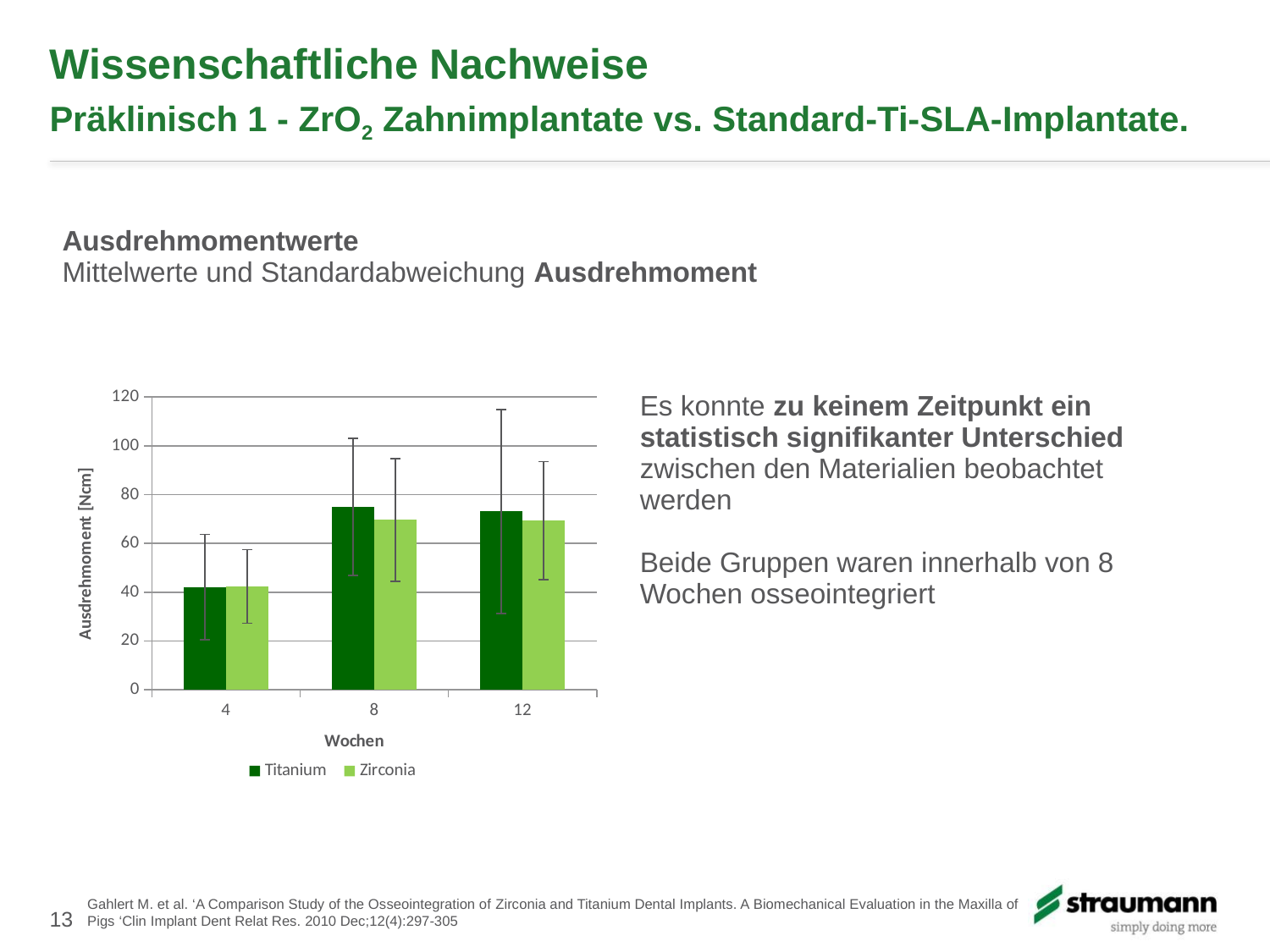
At which week is the Titanium value lowest? 4 Do the Zirconia values rise or fall from 4 weeks to 8 weeks? rise What kind of chart is shown on the slide? bar chart How many series does the legend list? 2 At which week is the Zirconia value lowest? 4 Which is larger for Titanium: the value at 4 weeks or at 8 weeks? 8 weeks Is the Zirconia value at 12 weeks greater or less than 40? greater Is the Titanium value at 4 weeks greater or less than 60? less Is the Titanium value at 8 weeks greater or less than 60? greater How many categories (week time points) are shown on the x axis? 3 What is the label of the y axis? Ausdrehmoment [Ncm]